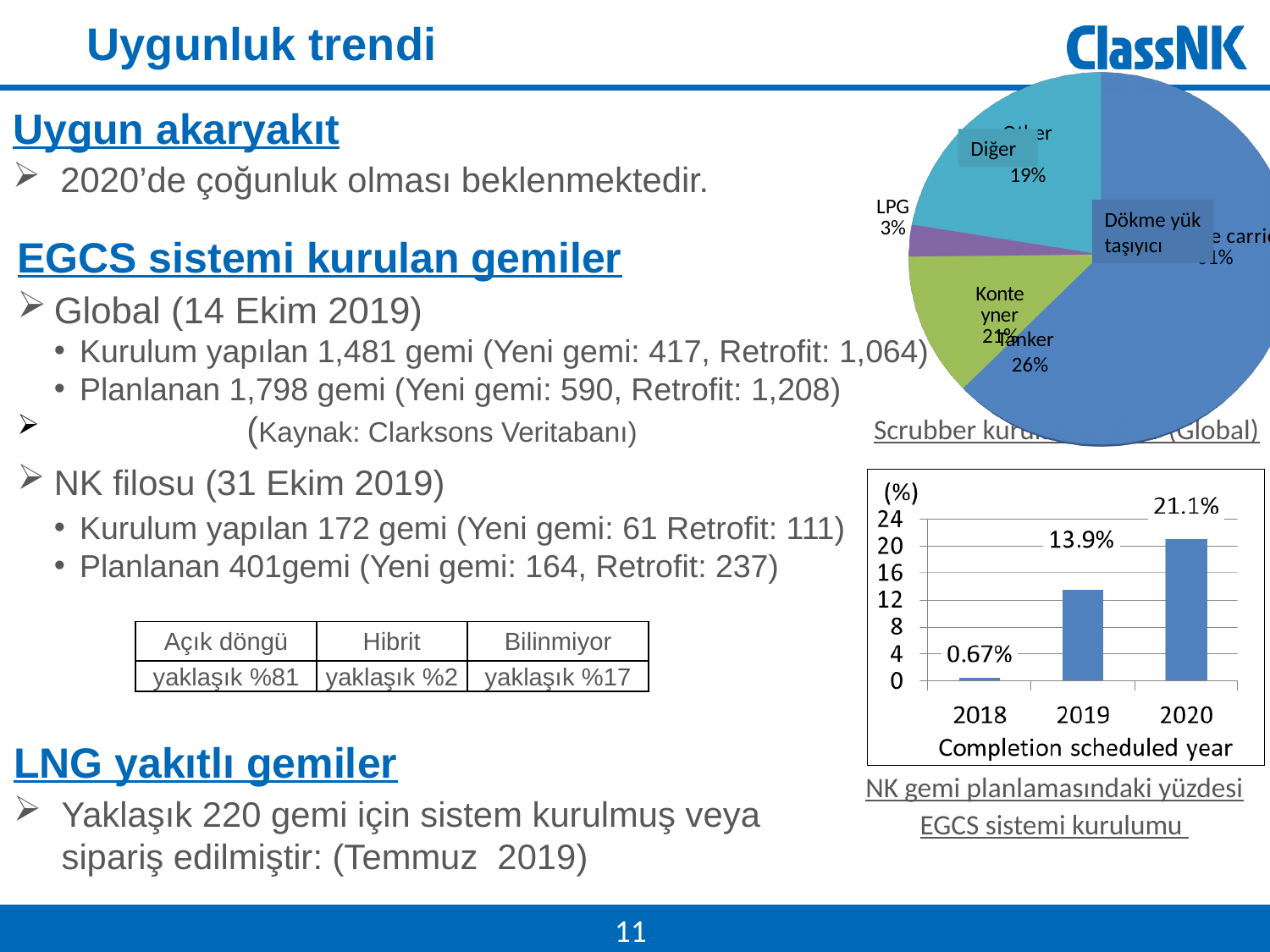
In the bar chart at the bottom right, which year has the highest value? 2020 In the bar chart at the bottom right, what is the value for 2020? 21.1% In the bar chart at the bottom right, how many years are shown on the x axis? 3 In the bar chart at the bottom right, do the values rise or fall from 2018 to 2020? rise In the pie chart at the top right, which category has the smallest slice? LPG In the bar chart at the bottom right, what is the difference between the values for 2020 and 2019? 7.2% In the bar chart at the bottom right, what is the value for 2018? 0.67% In the bar chart at the bottom right, which year has the lowest value? 2018 In the bar chart at the bottom right, what is the value for 2019? 13.9% In the bar chart at the bottom right, what is the x-axis title? Completion scheduled year In the pie chart at the top right, what share does Tanker have? 26% What kind of chart is the chart at the bottom right of the slide? bar chart